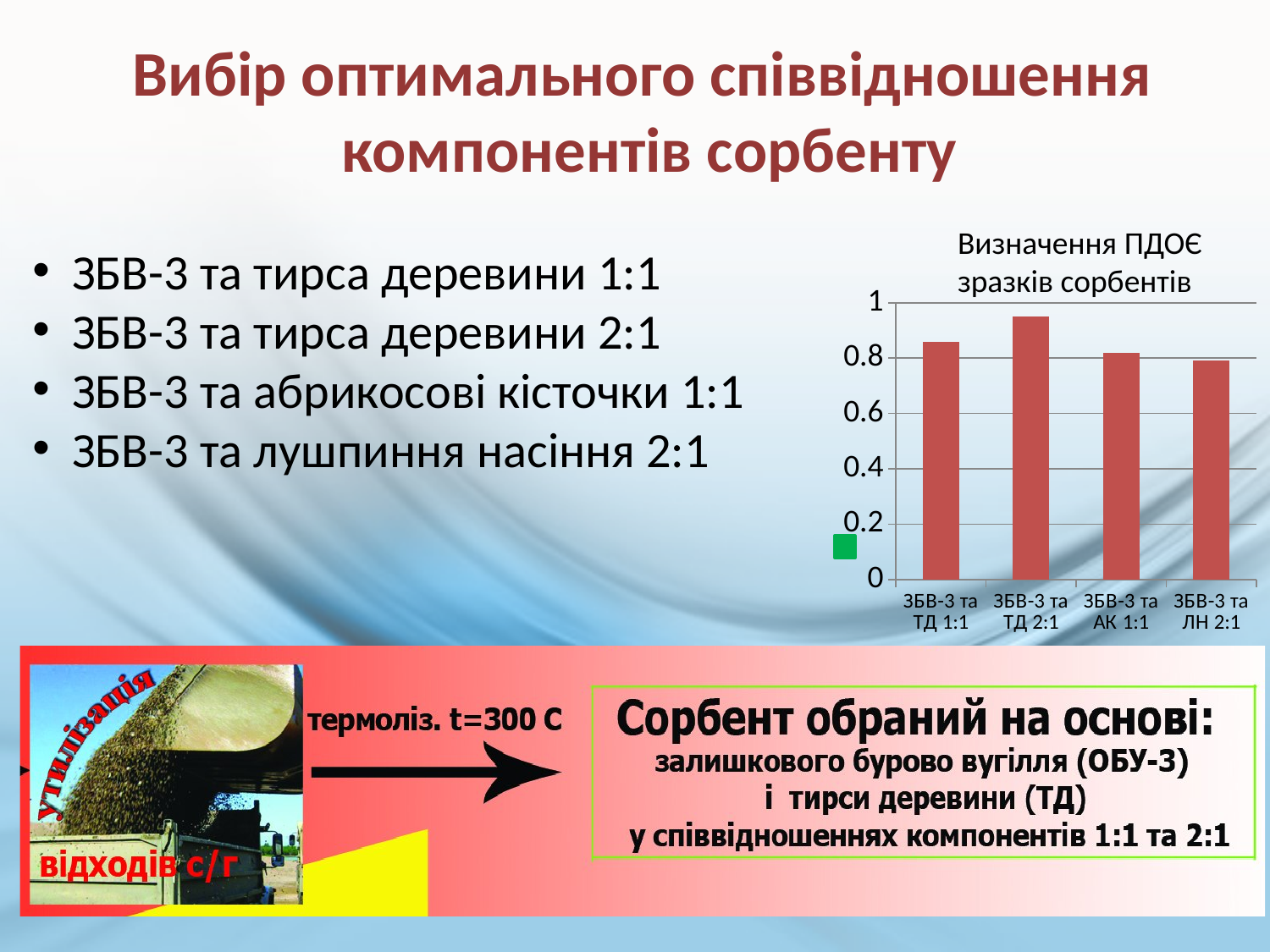
What is the highest value shown on the chart's vertical axis? 1 What kind of chart is shown on the slide? bar chart Is the value for ЗБВ-3 та АК 1:1 greater or less than 0.6? greater Which is larger, the value for ЗБВ-3 та ТД 1:1 or for ЗБВ-3 та ЛН 2:1? ЗБВ-3 та ТД 1:1 Which is larger, the value for ЗБВ-3 та ТД 2:1 or for ЗБВ-3 та ТД 1:1? ЗБВ-3 та ТД 2:1 How many bars (categories) does the chart show? 4 Which category has the highest bar in the chart? ЗБВ-3 та ТД 2:1 Is the value for ЗБВ-3 та ТД 2:1 greater or less than 1? less Is the value for ЗБВ-3 та ТД 1:1 greater or less than 0.8? greater What is the title of the chart? Визначення ПДОЄ зразків сорбентів